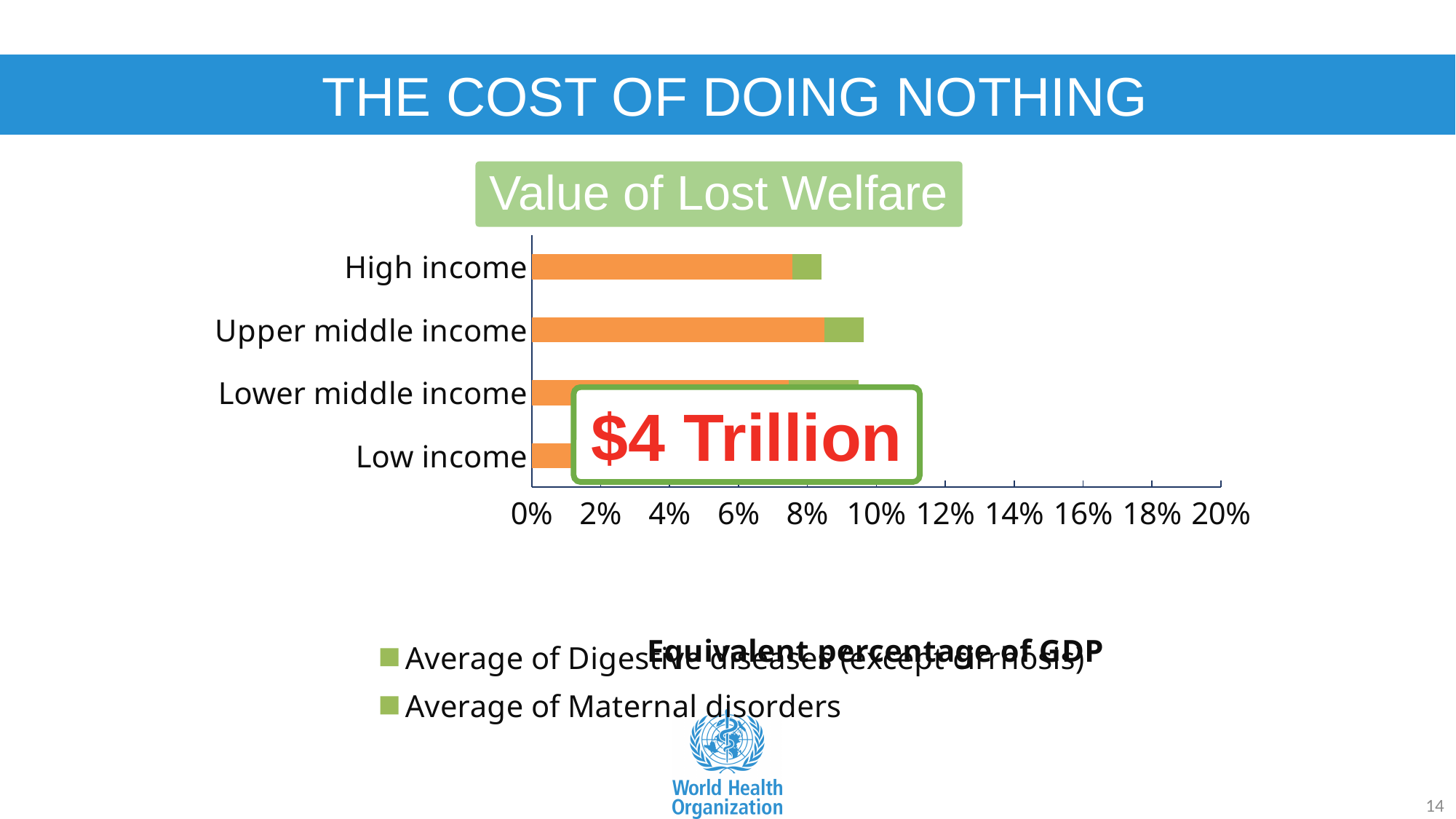
How many income categories are plotted on the chart? 4 What is the highest value shown on the horizontal axis? 20% Is the total bar length for High income greater or less than 10%? less Which has the longer total bar, High income or Upper middle income? Upper middle income How many series does the legend list? 2 What kind of chart is shown on the slide? bar chart Is the total bar length for Upper middle income greater or less than 6%? greater What dollar figure is shown in the callout box over the chart? $4 Trillion Is the total bar length for High income greater or less than 4%? greater What is the title of the chart? Value of Lost Welfare